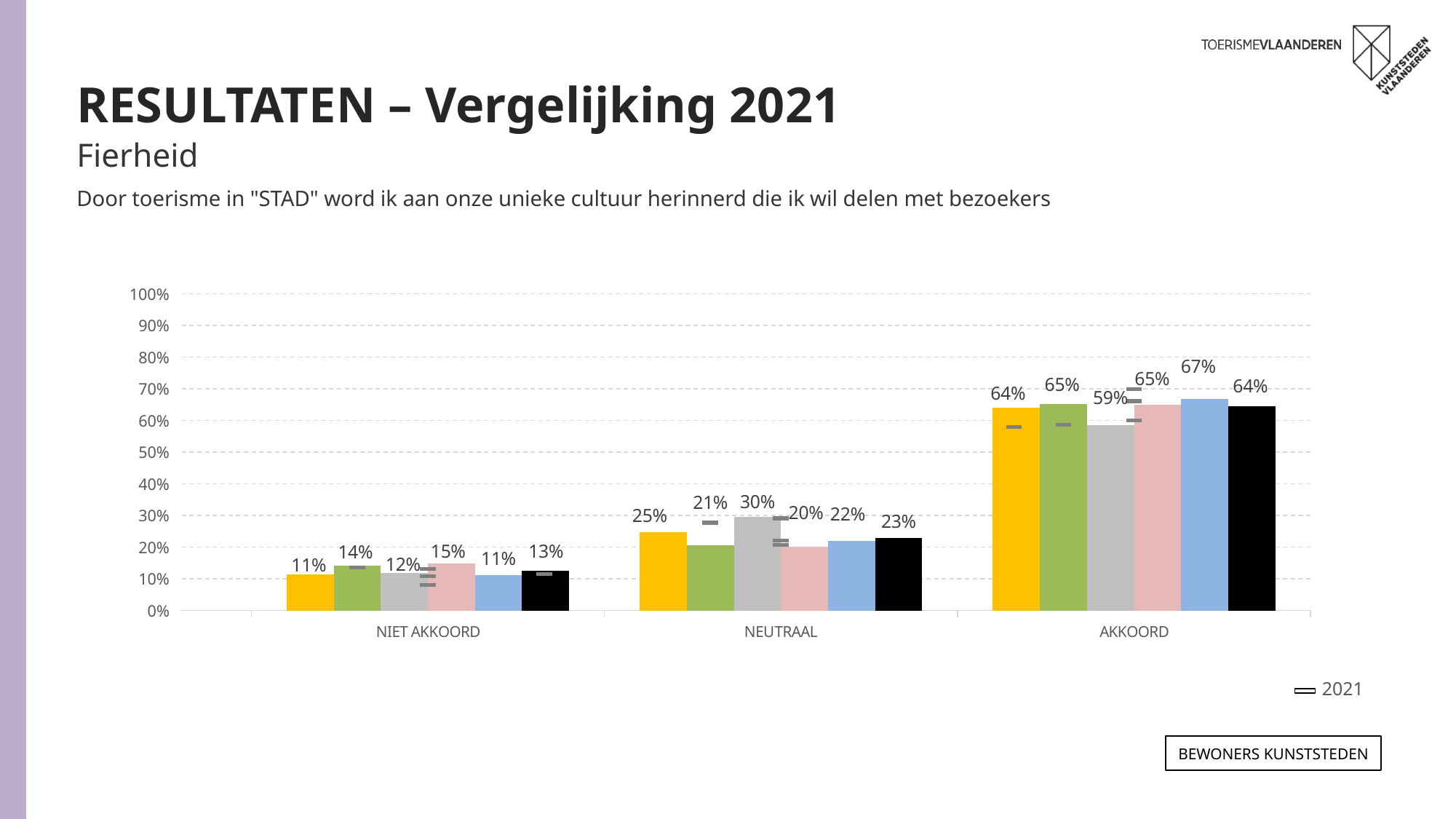
How many categories are shown on the x axis? 3 Is the value of the yellow bar for AKKOORD greater or less than 50%? greater What is the difference between the grey bar and the pink bar in the NEUTRAAL group? 10 percentage points Which coloured bar is the lowest in the AKKOORD group? Grey (59%) What is the value of the grey bar for NEUTRAAL? 30% What is the value of the yellow bar for NIET AKKOORD? 11% What is the value of the blue bar for AKKOORD? 67% What year does the legend marker below the chart refer to? 2021 What is the value of the black bar for NEUTRAAL? 23% What kind of chart is shown on the slide? Bar chart Which coloured bar is the highest in the AKKOORD group? Blue (67%) Which is larger in the NIET AKKOORD group, the pink bar or the green bar? Pink (15%)